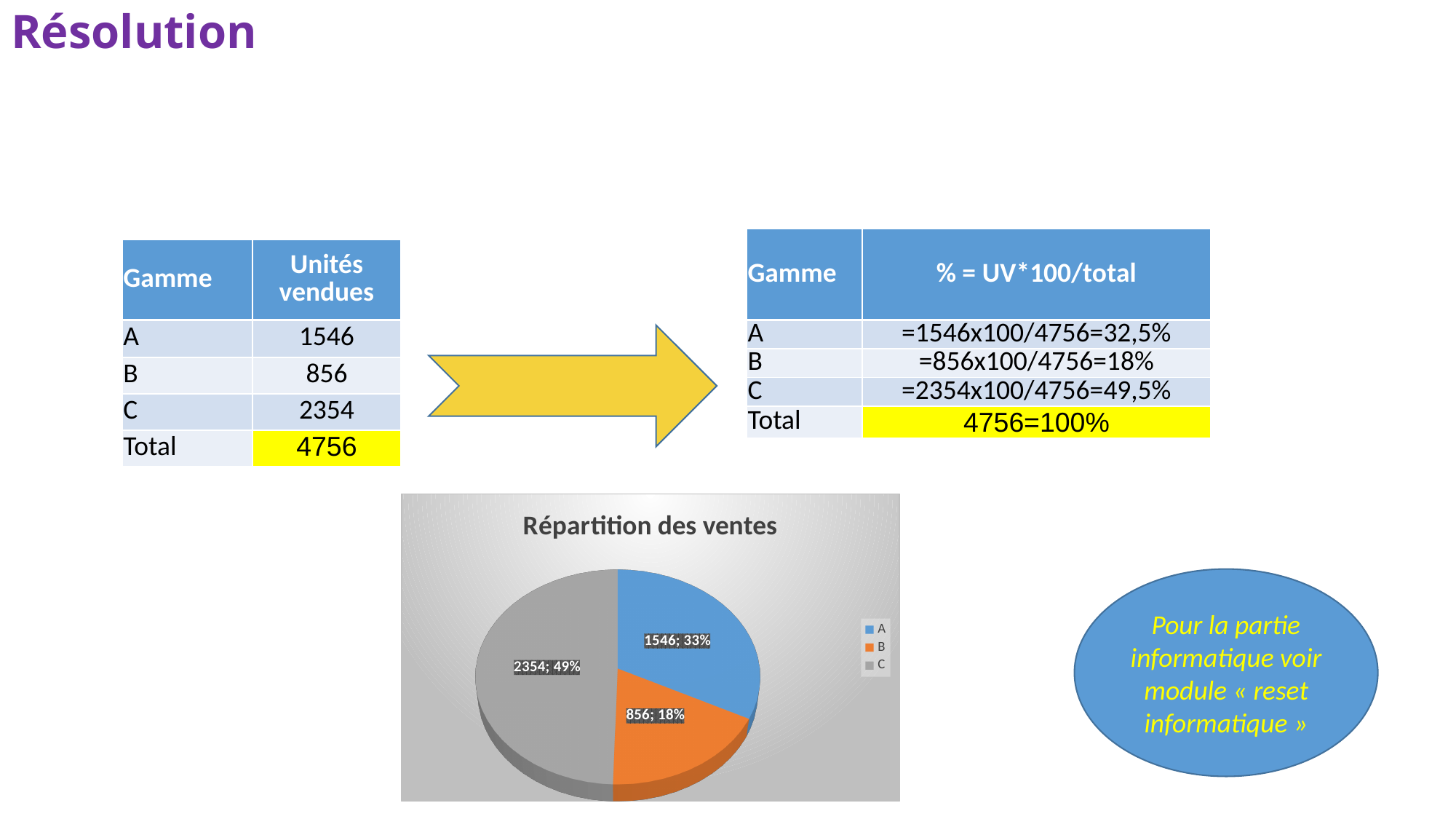
Which slice of the pie chart is the smallest? B What share of the pie does slice B represent? 18% What value is shown for slice A in the pie chart? 1546 What is the difference between the values for slice C and slice A? 808 What type of chart is shown on the slide? pie chart Which slice of the pie chart is the largest? C What is the title of the chart? Répartition des ventes What value is shown for slice B in the pie chart? 856 What value is shown for slice C in the pie chart? 2354 How many entries does the chart legend list? 3 How many slices does the pie chart have? 3 What share of the pie does slice C represent? 49%